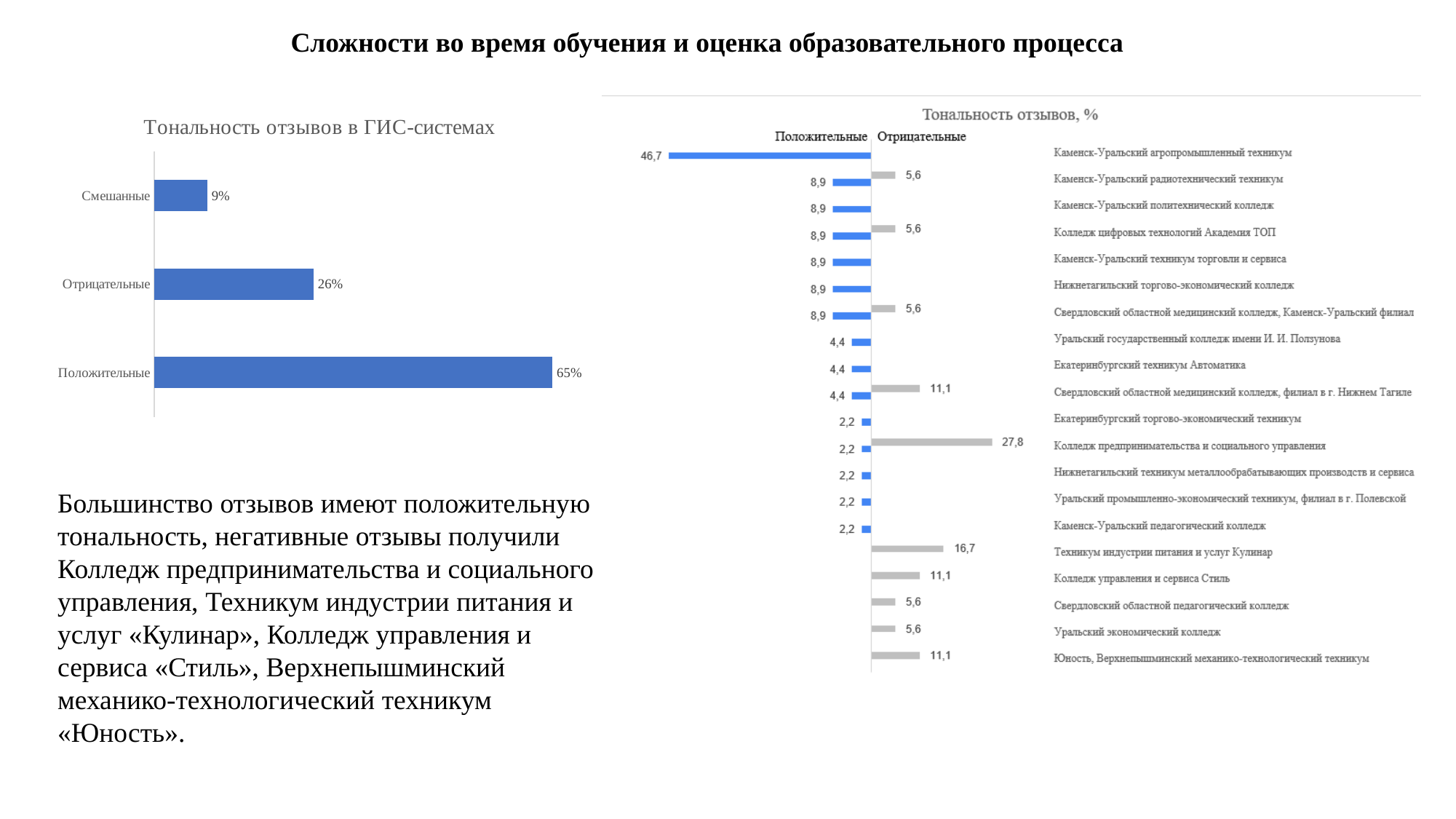
In the chart 'Тональность отзывов, %', which institution has the highest Отрицательные value? Колледж предпринимательства и социального управления In the chart 'Тональность отзывов, %', which is larger: the Отрицательные value for Колледж управления и сервиса Стиль or for Уральский экономический колледж? Колледж управления и сервиса Стиль In the chart 'Тональность отзывов в ГИС-системах', what is the value for Смешанные? 9% What kind of chart is 'Тональность отзывов в ГИС-системах'? Bar chart In the chart 'Тональность отзывов в ГИС-системах', what is the difference between Положительные and Отрицательные? 39% In the chart 'Тональность отзывов, %', what is the Отрицательные value for Колледж предпринимательства и социального управления? 27,8 In the chart 'Тональность отзывов, %', how many series are shown in the header? 2 In the chart 'Тональность отзывов в ГИС-системах', which category has the lowest value? Смешанные In the chart 'Тональность отзывов, %', what is the Отрицательные value for Техникум индустрии питания и услуг Кулинар? 16,7 In the chart 'Тональность отзывов, %', what is the Положительные value for Каменск-Уральский агропромышленный техникум? 46,7 In the chart 'Тональность отзывов в ГИС-системах', how many categories are shown? 3 In the chart 'Тональность отзывов в ГИС-системах', what is the value for Положительные? 65%